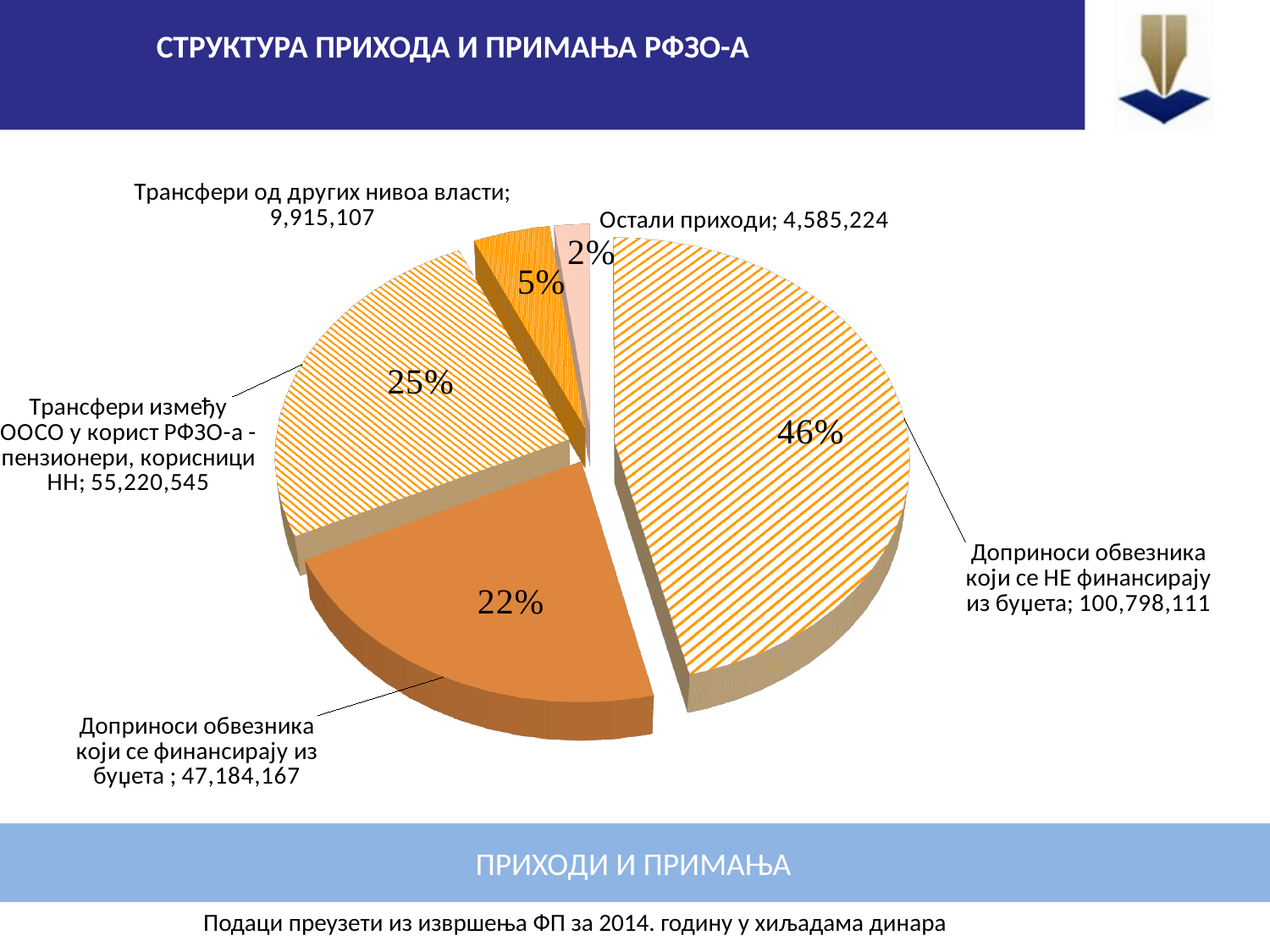
What is the difference between the values for "Доприноси обвезника који се НЕ финансирају из буџета" and "Доприноси обвезника који се финансирају из буџета"? 53,613,944 What is the title of the slide containing the chart? СТРУКТУРА ПРИХОДА И ПРИМАЊА РФЗО-А Which category has the largest slice of the pie? Доприноси обвезника који се НЕ финансирају из буџета How many slices does the pie chart have? 5 What is the value for "Трансфери од других нивоа власти"? 9,915,107 Which category has the smallest slice of the pie? Остали приходи Which is larger: "Трансфери између ООСО у корист РФЗО-а - пензионери, корисници НН" or "Доприноси обвезника који се финансирају из буџета"? Трансфери између ООСО у корист РФЗО-а - пензионери, корисници НН What share of the pie does "Трансфери између ООСО у корист РФЗО-а - пензионери, корисници НН" represent? 25% What is the value for "Доприноси обвезника који се НЕ финансирају из буџета"? 100,798,111 What is the value for "Остали приходи"? 4,585,224 What kind of chart is shown on the slide? Pie chart What share of the pie does "Доприноси обвезника који се финансирају из буџета" represent? 22%